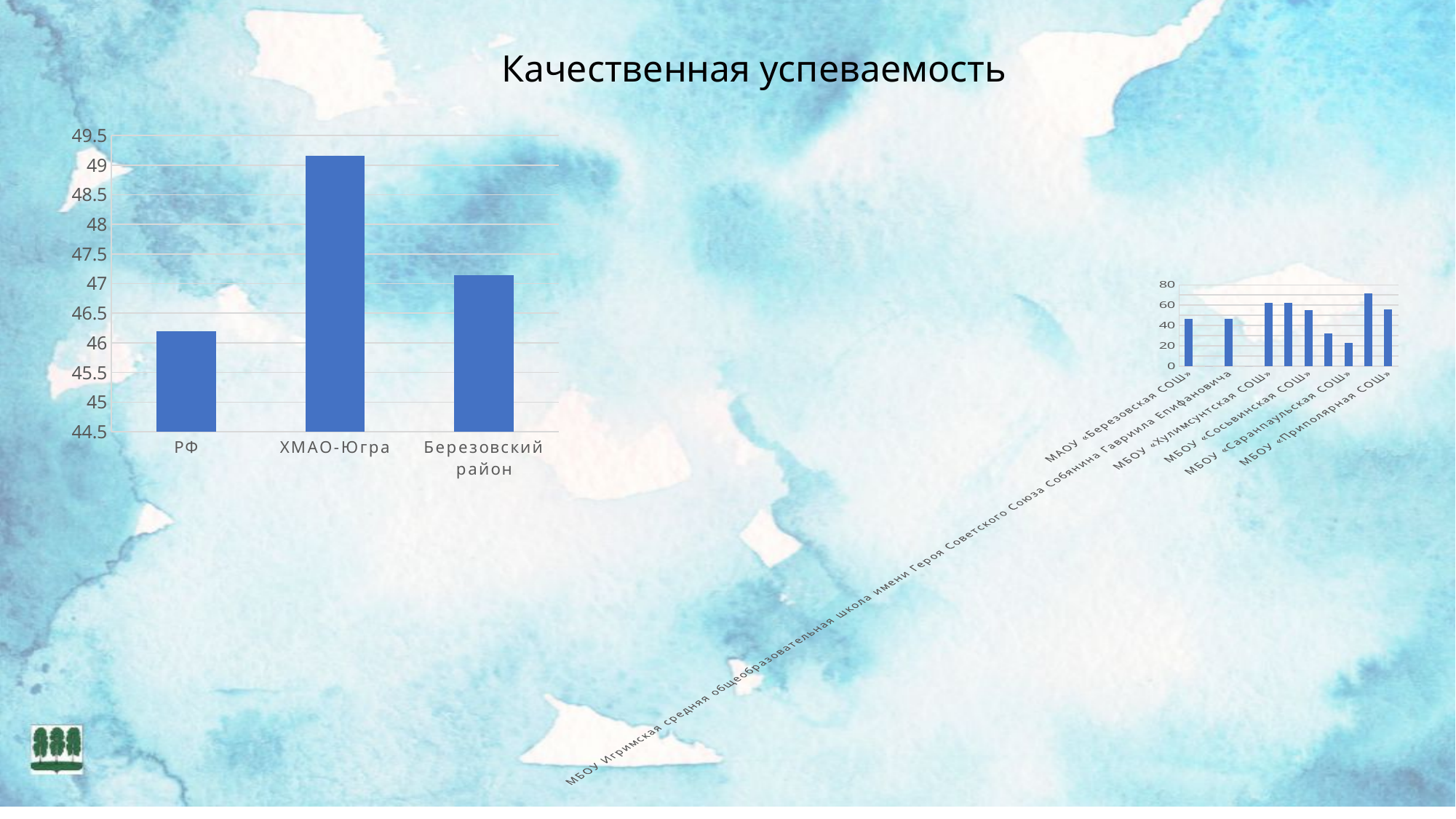
On the left chart, what is the highest value shown on the vertical axis? 49.5 On the left chart, which category has the highest value? ХМАО-Югра On the left chart, which category has the lowest value? РФ On the left chart, how many categories are plotted? 3 What kind of chart is the left chart? bar chart On the left chart, is the value for Березовский район greater or less than 47? greater On the left chart, which is larger: the value for РФ or the value for Березовский район? Березовский район On the left chart, is the value for РФ greater or less than 46.5? less What kind of chart is the right chart? bar chart On the left chart, is the value for ХМАО-Югра greater or less than 49? greater What is the title of the slide? Качественная успеваемость